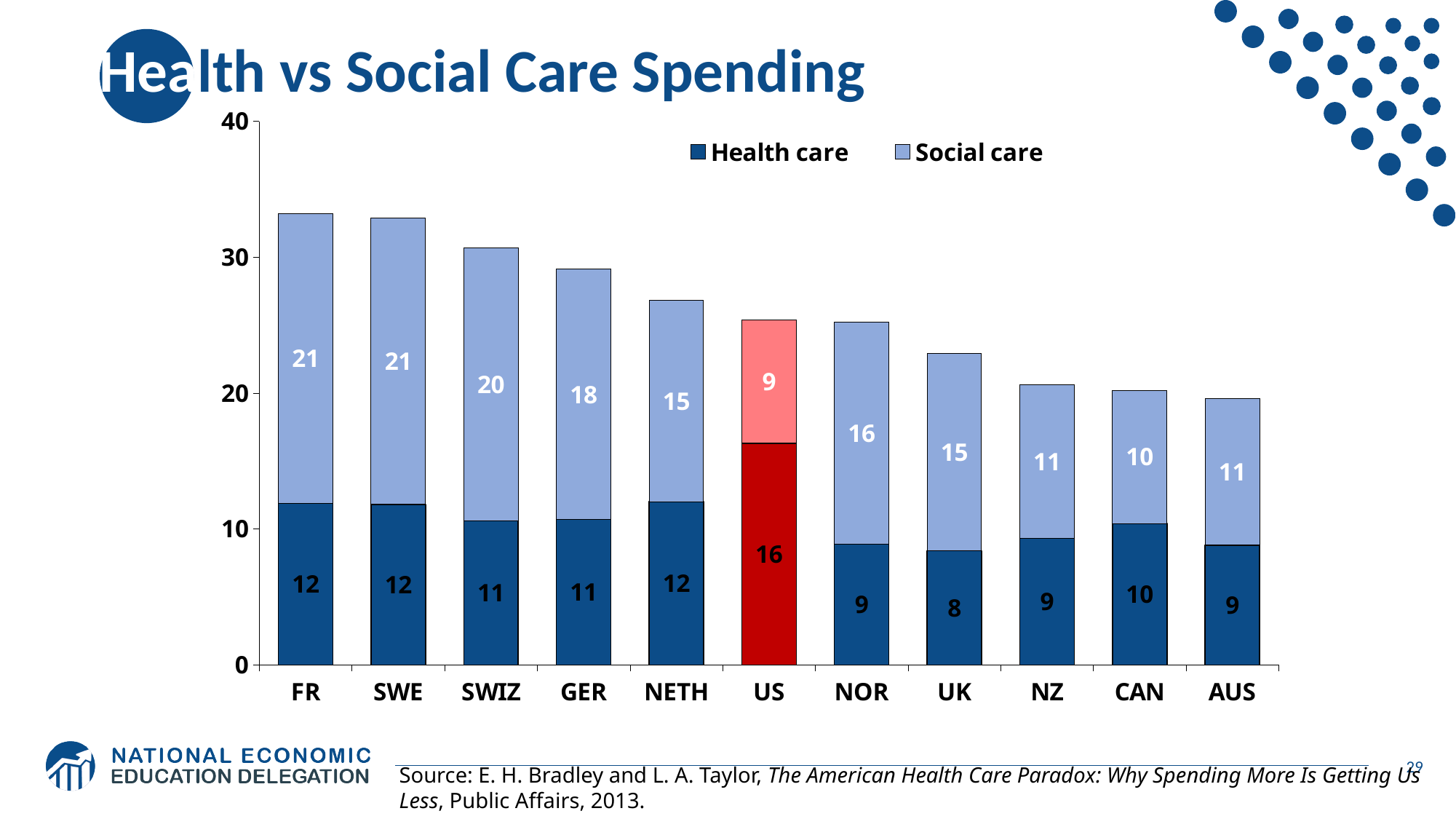
Which country has the lowest Social care value? US What kind of chart is shown on the slide? stacked bar chart What is the difference between the Health care value for the US and the Health care value for the UK? 8 What is the Social care value for Germany (GER)? 18 What is the total of the stacked bar for France (FR), using the printed labels? 33 What is the Health care value for the US? 16 Which country's bar is highlighted in red rather than blue? US How many series does the legend list? 2 Which country has the lowest Health care value? UK How many countries are shown on the x axis? 11 Is the Social care value for Norway (NOR) larger or smaller than the Social care value for the UK? larger Which country has the highest Health care value? US